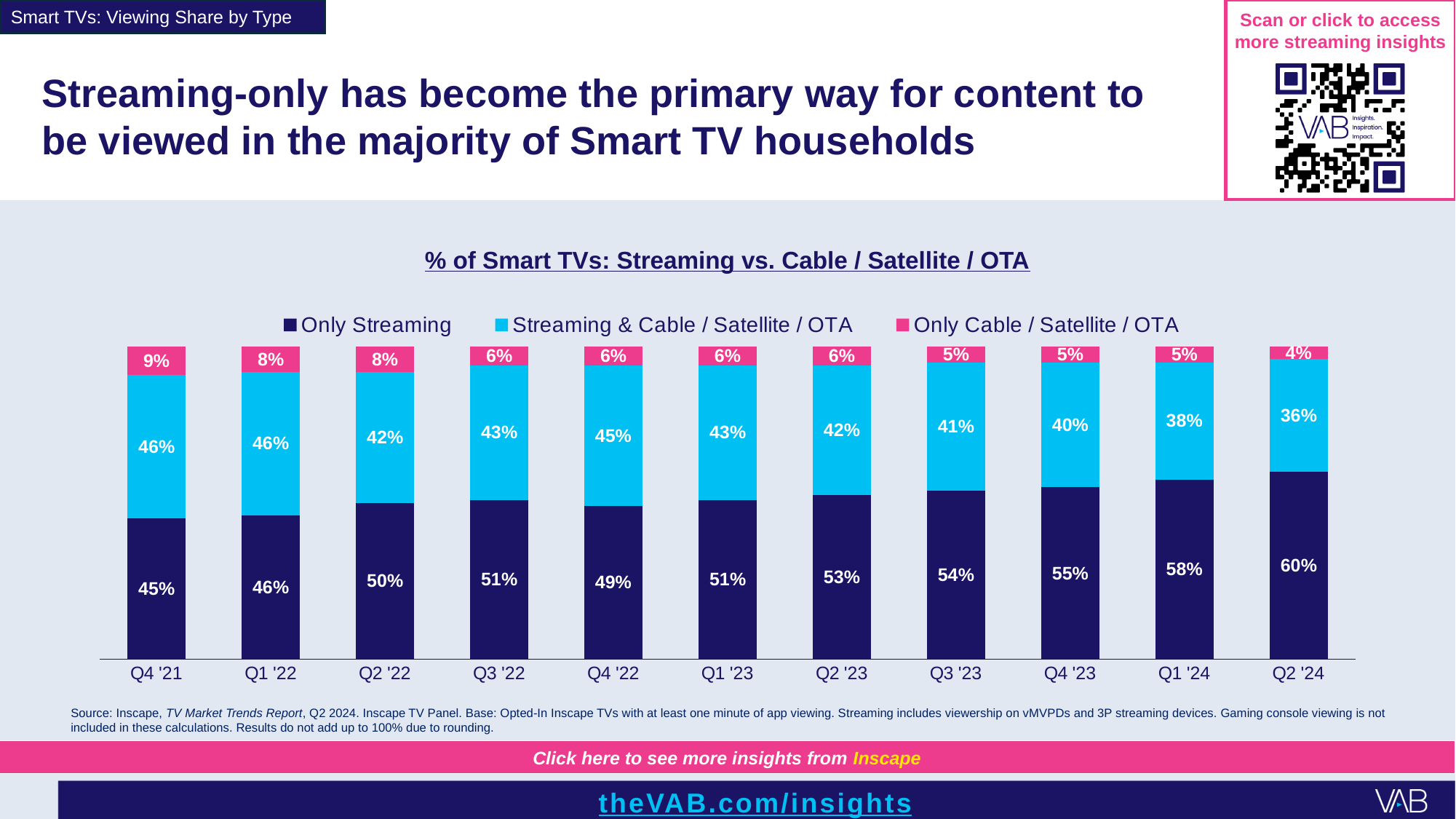
What is the Only Streaming value for Q2 '24? 60% Which quarter has the lowest Only Cable / Satellite / OTA value? Q2 '24 What is the Only Cable / Satellite / OTA value for Q3 '22? 6% What is the total of the stacked bar for Q2 '22? 100% Does the Streaming & Cable / Satellite / OTA value generally rise or fall from Q4 '21 to Q2 '24? Fall What kind of chart is shown? Stacked bar chart How many quarters are shown on the x axis? 11 Which is larger: the Only Streaming value for Q4 '22 or for Q1 '23? Q1 '23 What is the difference between the Only Streaming values for Q2 '24 and Q4 '21? 15% How many series does the legend list? 3 Which quarter has the highest Only Streaming value? Q2 '24 What is the Streaming & Cable / Satellite / OTA value for Q4 '21? 46%